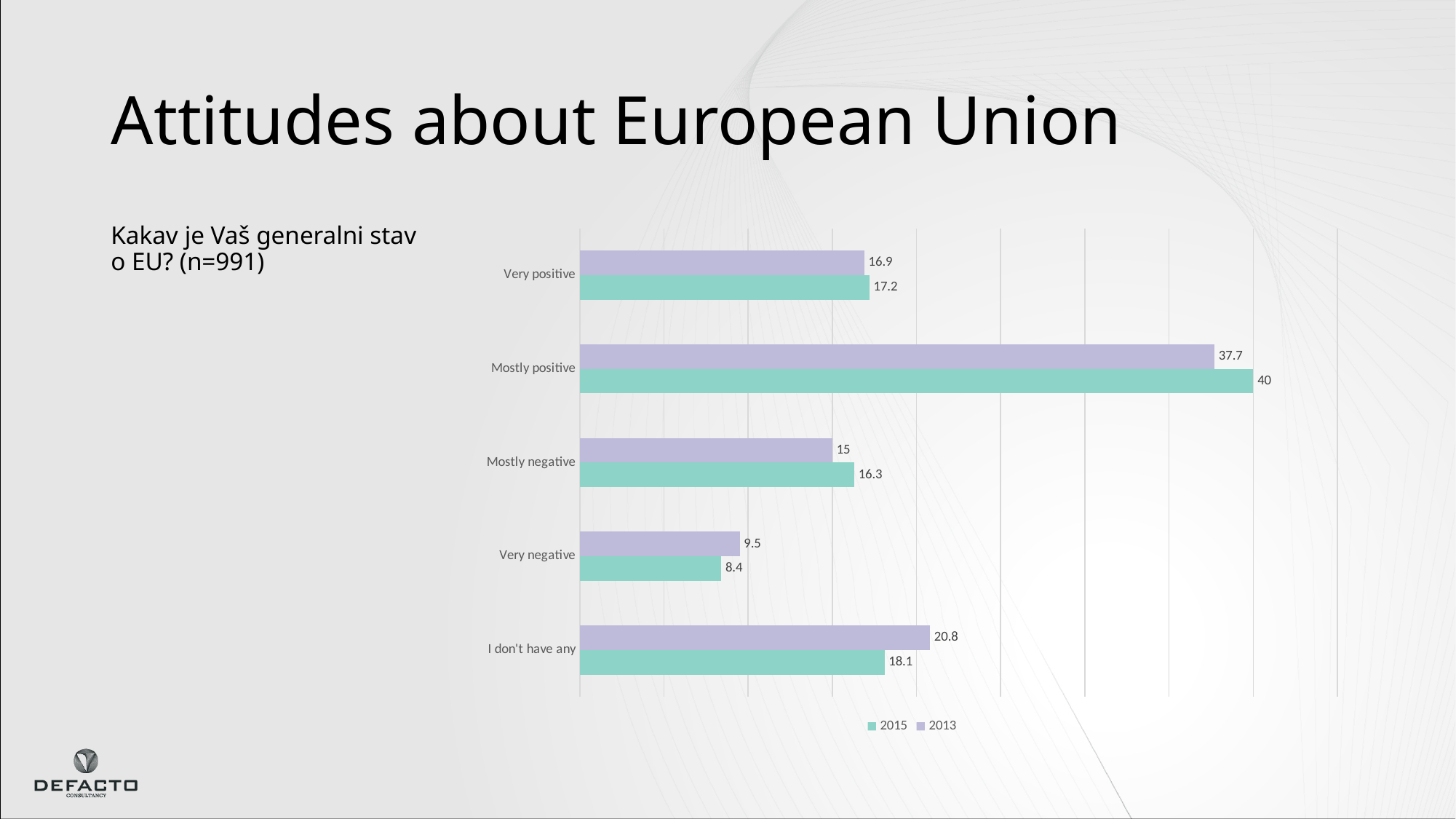
What is the 2015 value for Mostly negative? 16.3 Which series is shown in green? 2015 Which is larger for I don't have any, the 2015 value or the 2013 value? 2013 What is the 2013 value for Very negative? 9.5 What is the difference between the 2015 and 2013 values for Mostly positive? 2.3 How many categories are shown on the chart? 5 What kind of chart is shown on the slide? Bar chart How many series does the legend list? 2 What is the 2015 value for Mostly positive? 40 What is the 2013 value for I don't have any? 20.8 Which category has the lowest 2013 value? Very negative Which category has the highest 2015 value? Mostly positive